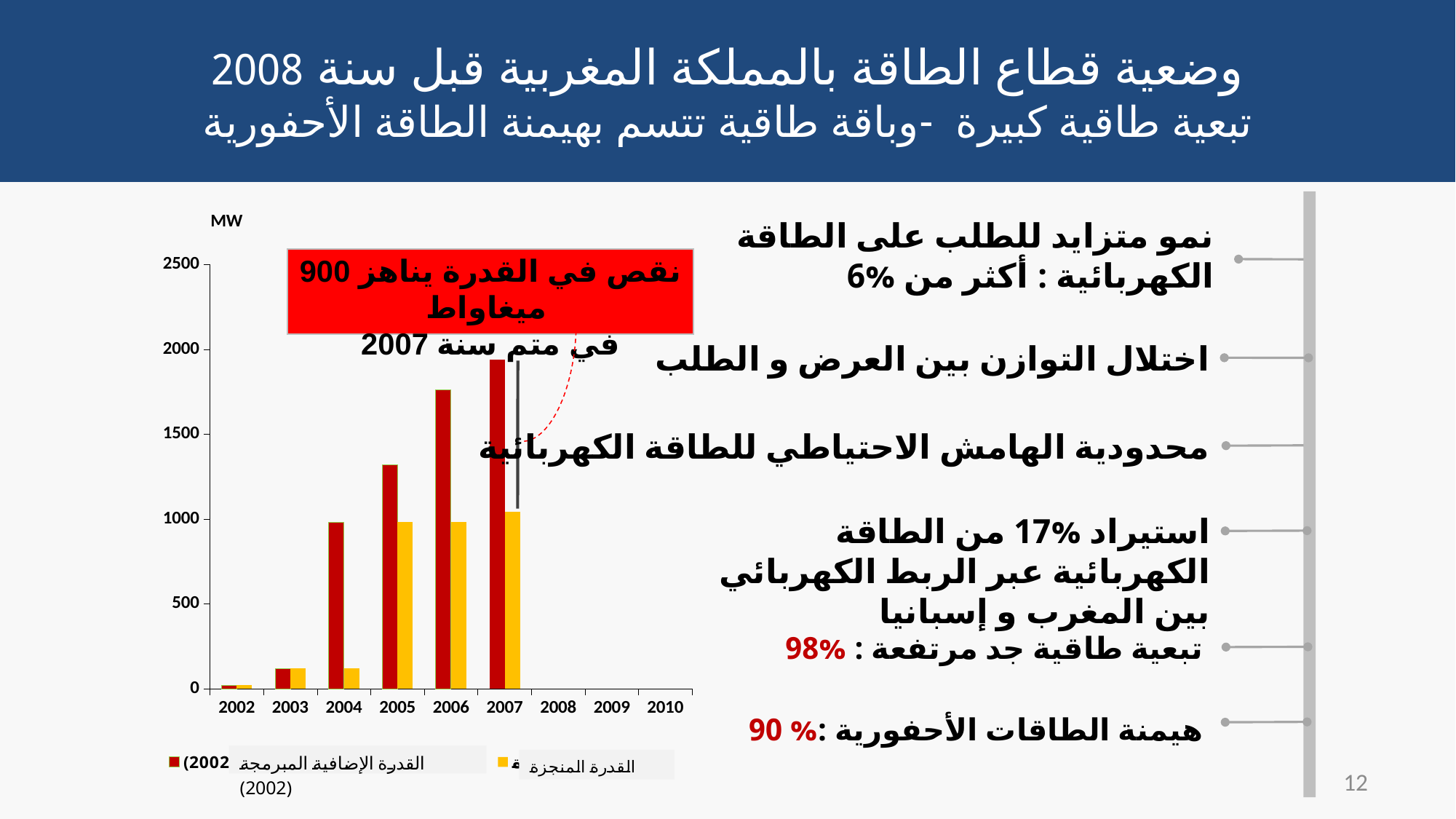
What unit is shown on the y axis of the chart? MW Is the value of the red series (القدرة الإضافية المبرمجة) for 2007 greater or less than 1500? greater What type of chart is shown on the slide? Bar chart For 2007, which series is larger: the red series (القدرة الإضافية المبرمجة) or the yellow series (القدرة المنجزة)? The red series (القدرة الإضافية المبرمجة) Does the red series (القدرة الإضافية المبرمجة) rise or fall from 2002 to 2007? Rise Is the value of the red series (القدرة الإضافية المبرمجة) for 2003 greater or less than 500? less How many years are labelled on the x axis of the chart? 9 Is the value of the yellow series (القدرة المنجزة) for 2004 greater or less than 500? less In which year is the red series (القدرة الإضافية المبرمجة) highest? 2007 What capacity shortfall does the red annotation box on the chart state? نقص في القدرة يناهز 900 ميغاواط How many series does the chart's legend list? 2